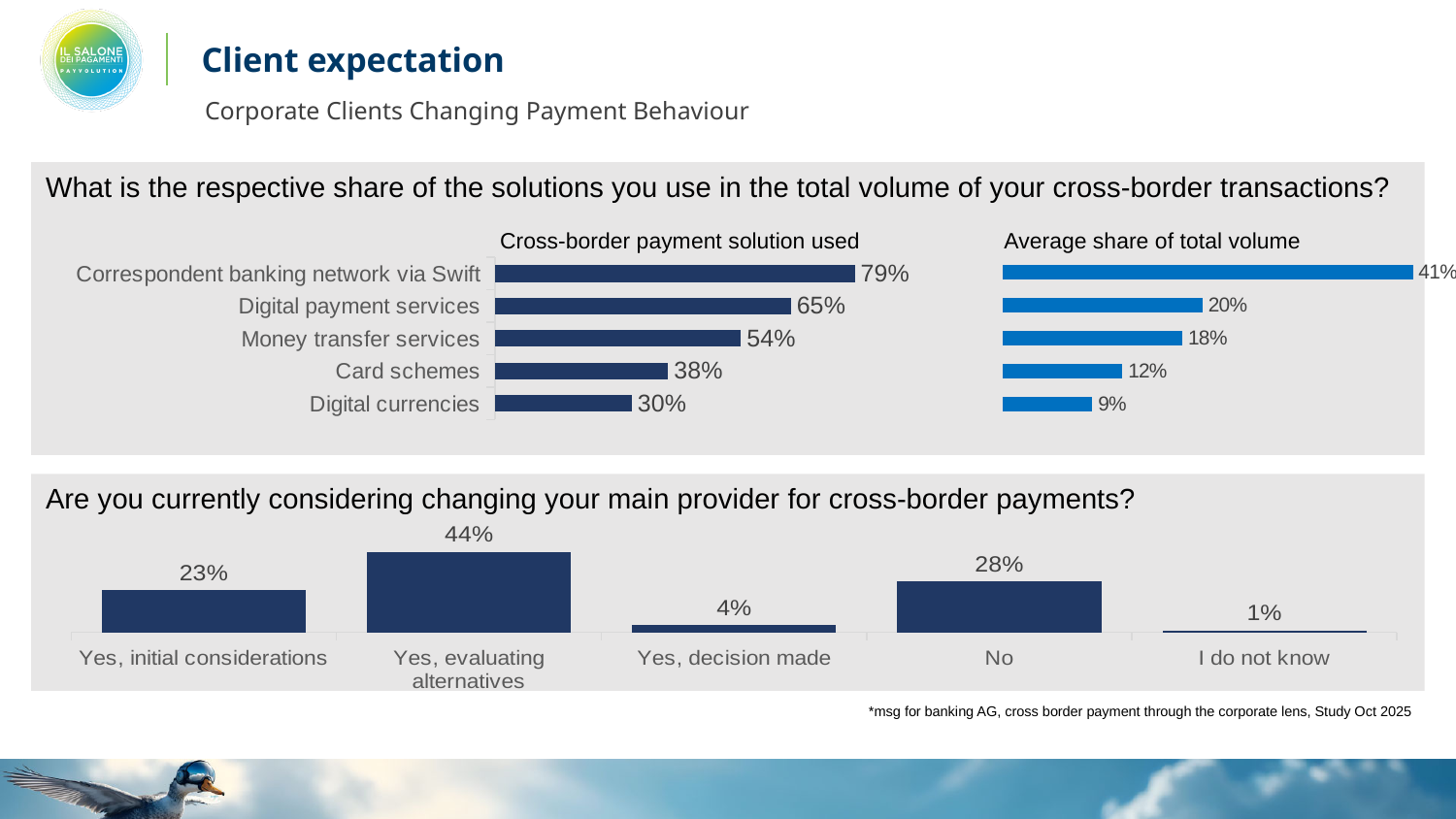
In the 'Average share of total volume' chart, what is the value for Money transfer services? 18% In the 'Average share of total volume' chart, which category has the lowest value? Digital currencies In the 'Cross-border payment solution used' chart, what is the difference between Correspondent banking network via Swift and Digital currencies? 49% In the 'Average share of total volume' chart, which is larger: Card schemes or Digital payment services? Digital payment services In the bottom chart about changing the main provider, what is the difference between 'No' and 'Yes, decision made'? 24% In the 'Cross-border payment solution used' chart, what is the value for Digital payment services? 65% In the bottom chart about changing the main provider, which category has the lowest value? I do not know In the bottom chart about changing the main provider, what is the value for 'Yes, evaluating alternatives'? 44% What kind of chart is the bottom chart about changing the main provider for cross-border payments? Bar chart In the 'Cross-border payment solution used' chart, which category has the highest value? Correspondent banking network via Swift What is the title of the right-hand chart in the top panel? Average share of total volume How many categories are shown in the 'Cross-border payment solution used' chart? 5